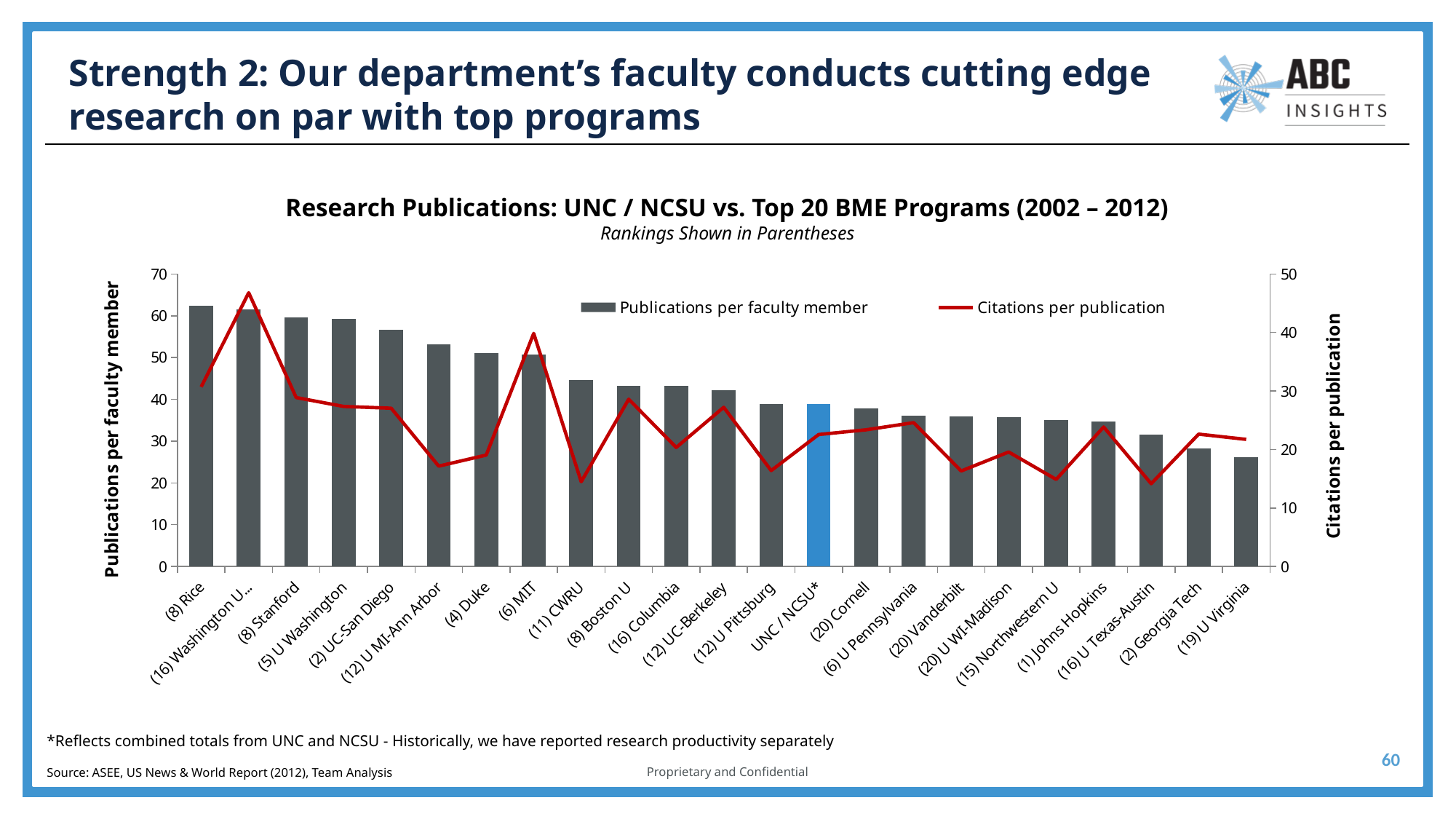
Is the value of citations per publication for (11) CWRU greater or less than 20? less Which program has the lowest publications per faculty member? (19) U Virginia Is the value of citations per publication for (6) MIT greater or less than 30? greater What is the title of the chart? Research Publications: UNC / NCSU vs. Top 20 BME Programs (2002 – 2012) Which program's bar is highlighted in blue rather than dark grey? UNC / NCSU* Which has more publications per faculty member, (4) Duke or (20) Cornell? (4) Duke How many programs (categories) are shown on the x axis of the chart? 23 Is the value of publications per faculty member for UNC / NCSU* greater or less than 30? greater Do the publications per faculty member bars generally rise or fall from left to right across the x axis? fall How many series does the chart legend list? 2 Which program has the highest citations per publication? (16) Washington U